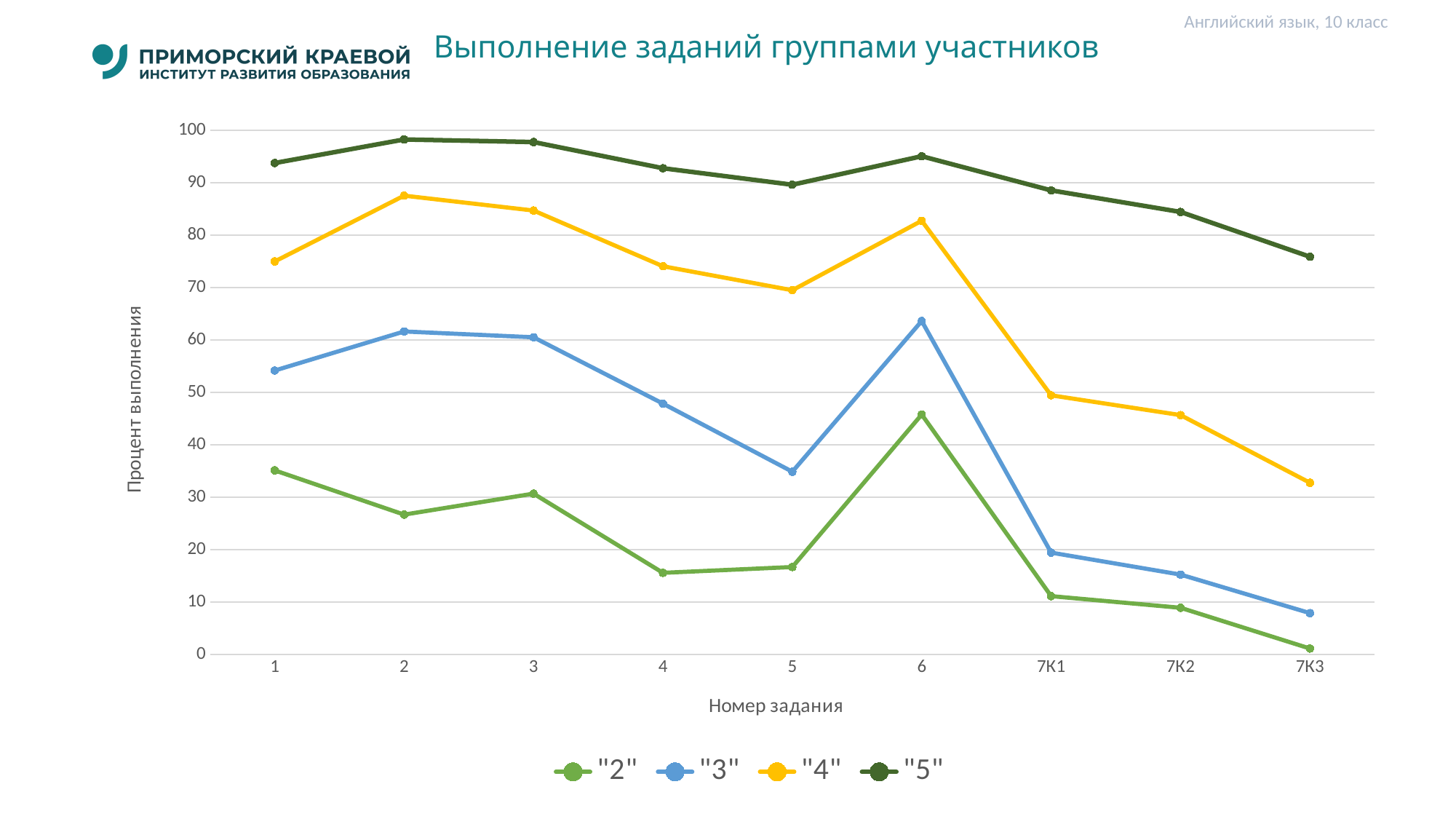
Is the value for series "5" at task 7К3 greater or less than 70? greater At task 1, which series has the larger value, "3" or "4"? "4" For which task number does the series "3" have its lowest value? 7К3 How many task numbers are shown along the x axis? 9 What kind of chart is shown on the slide? Line chart For which task number does the series "5" have its lowest value? 7К3 Is the value for series "3" at task 5 greater or less than 40? less How many series does the legend list? 4 Is the value for series "2" at task 6 greater or less than 40? greater What is the title of the vertical axis? Процент выполнения For which task number does the series "2" reach its highest value? 6 Do the values of series "5" rise or fall from task 6 to task 7К3? fall